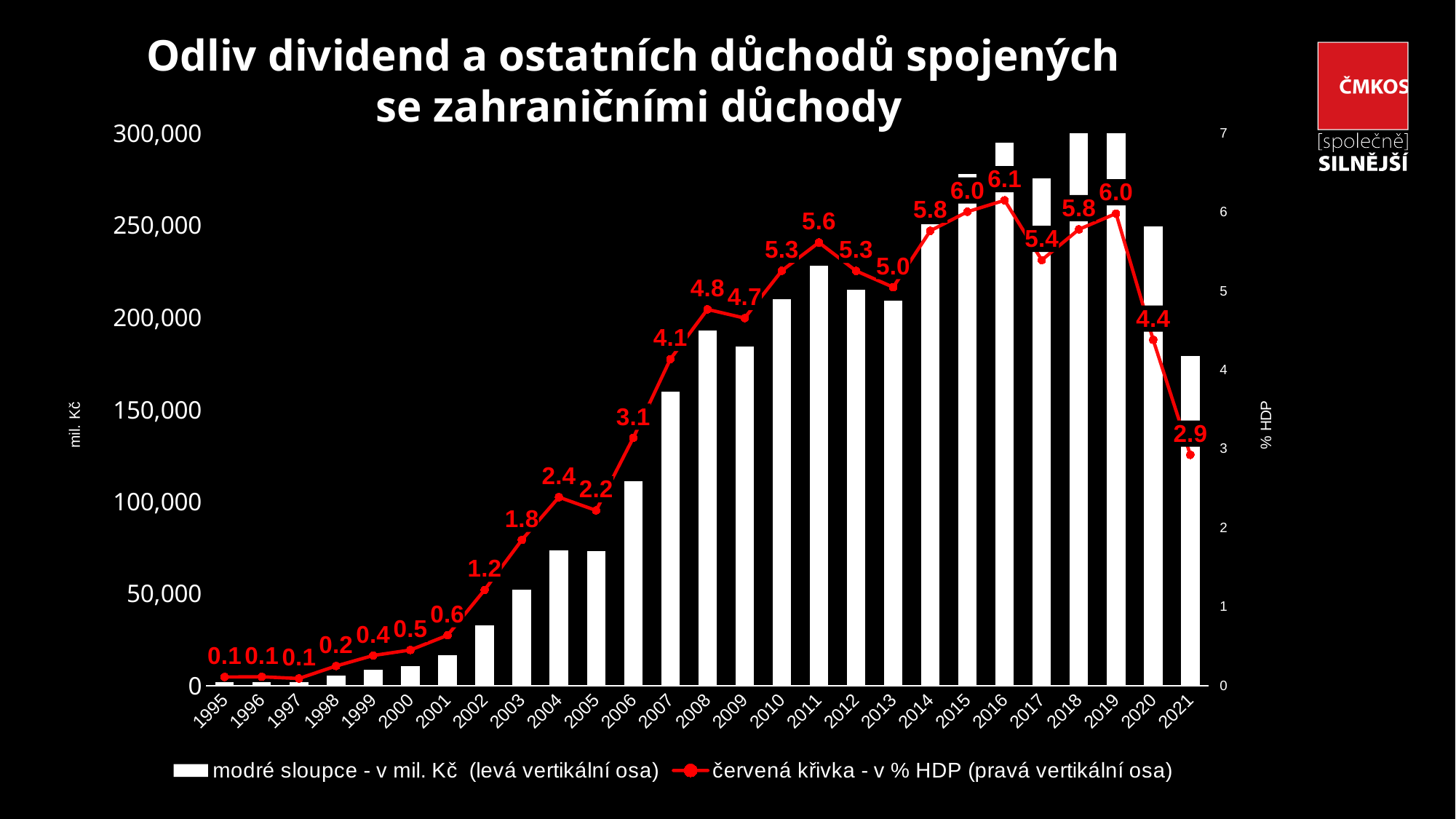
Which year has the larger red line value, 2011 or 2013? 2011 What kind of chart is shown on the slide? Combined bar and line chart What is the red line value (% HDP) for 2021? 2.9 In which year does the red line (% HDP) reach its highest value? 2016 What is the difference between the red line values for 2016 and 2021? 3.2 Is the bar value for 2004 greater or less than 50,000? greater What is the red line value (% HDP) for 2008? 4.8 How many years are shown on the x axis? 27 How many series does the legend list? 2 Is the bar value for 2021 greater or less than 200,000? less Does the red line rise or fall between 2019 and 2021? fall What is the red line value (% HDP) for 2016? 6.1